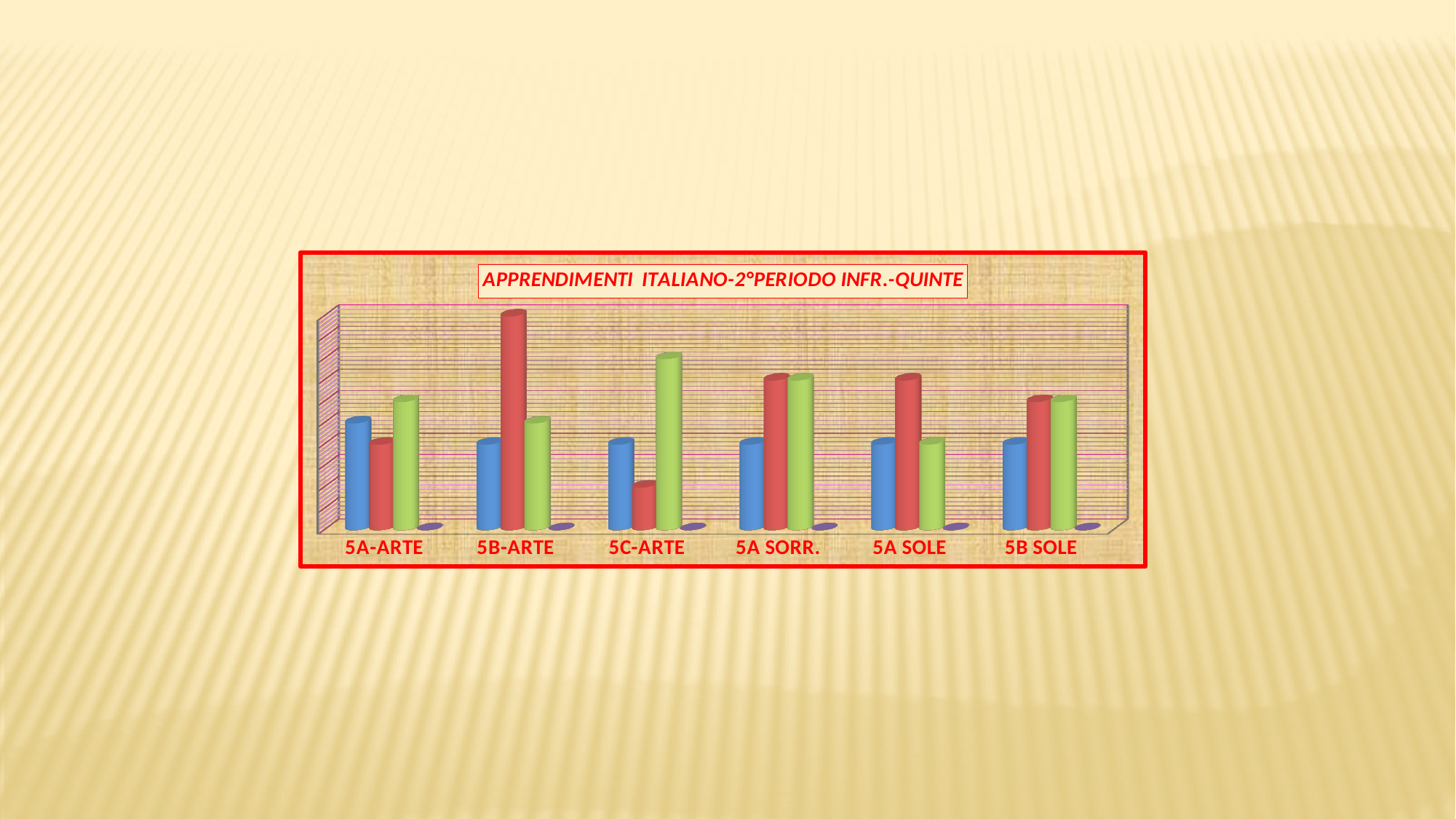
In the 5A-ARTE category, which bar is taller, the blue one or the red one? blue In the 5A SOLE category, which bar is taller, the red one or the green one? red Which category has the shortest red bar? 5C-ARTE Which category is the last one on the x axis of the chart? 5B SOLE What kind of chart is shown on the slide? bar chart Which category has the tallest green bar? 5C-ARTE How many categories are shown along the x axis of the chart? 6 What is the title of the chart? APPRENDIMENTI ITALIANO-2°PERIODO INFR.-QUINTE Which category has the tallest red bar? 5B-ARTE In the 5B-ARTE category, which bar is taller, the blue one or the red one? red How many bars are plotted for each category in the chart? 3